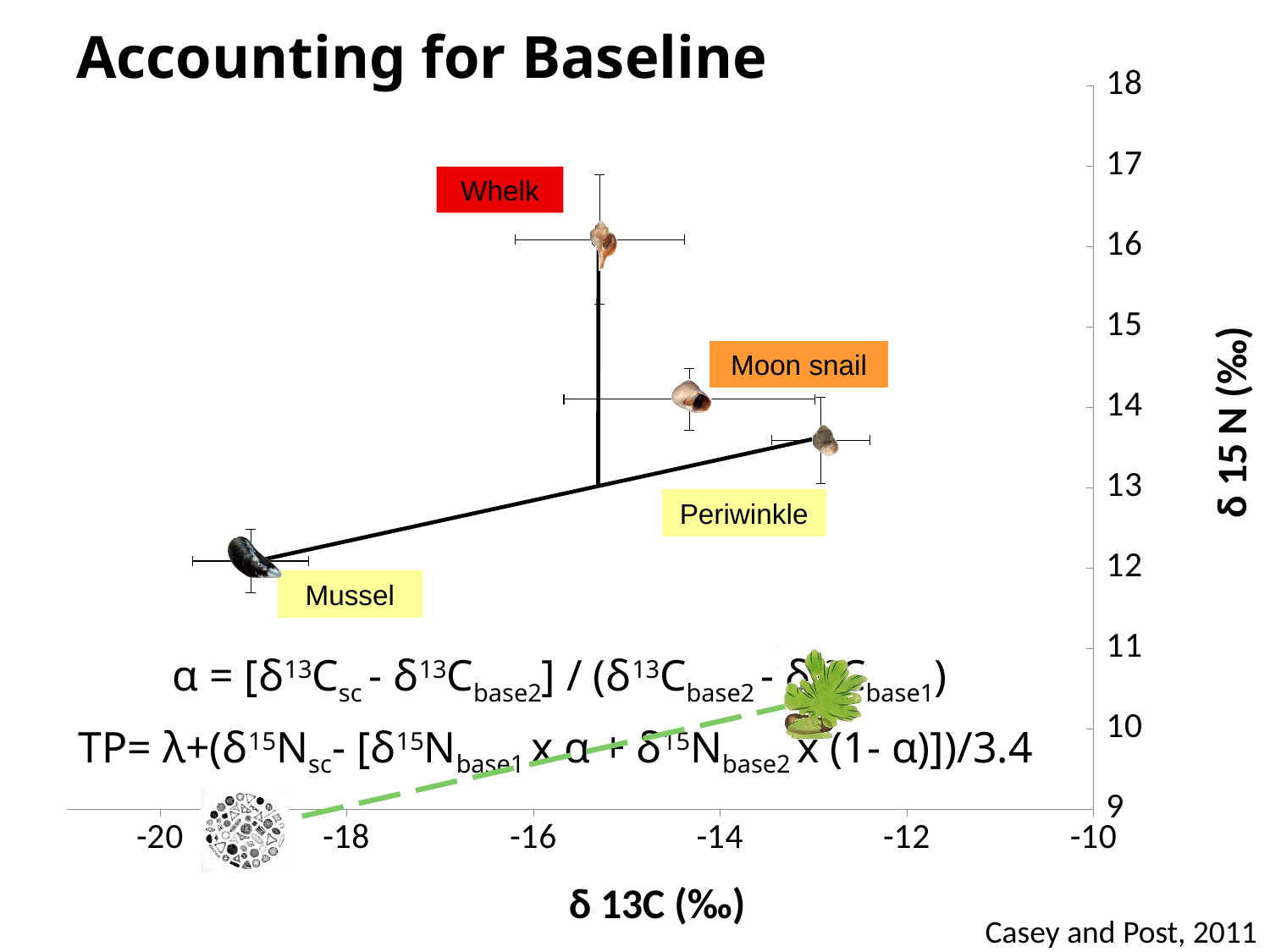
How many labeled organisms are plotted on the chart? 4 Is the δ15N value for Whelk greater or less than 15? greater What kind of chart is shown on the slide? scatter plot What is the label of the x axis? δ 13C (‰) Is the δ13C value for Periwinkle greater or less than -14? greater Which has a higher δ15N value, Whelk or Moon snail? Whelk Which organism has the highest (least negative) δ13C value? Periwinkle Which organism has the lowest δ15N value? Mussel Which organism has the highest δ15N value? Whelk Which organism has the lowest (most negative) δ13C value? Mussel Is the δ13C value for Mussel greater or less than -18? less